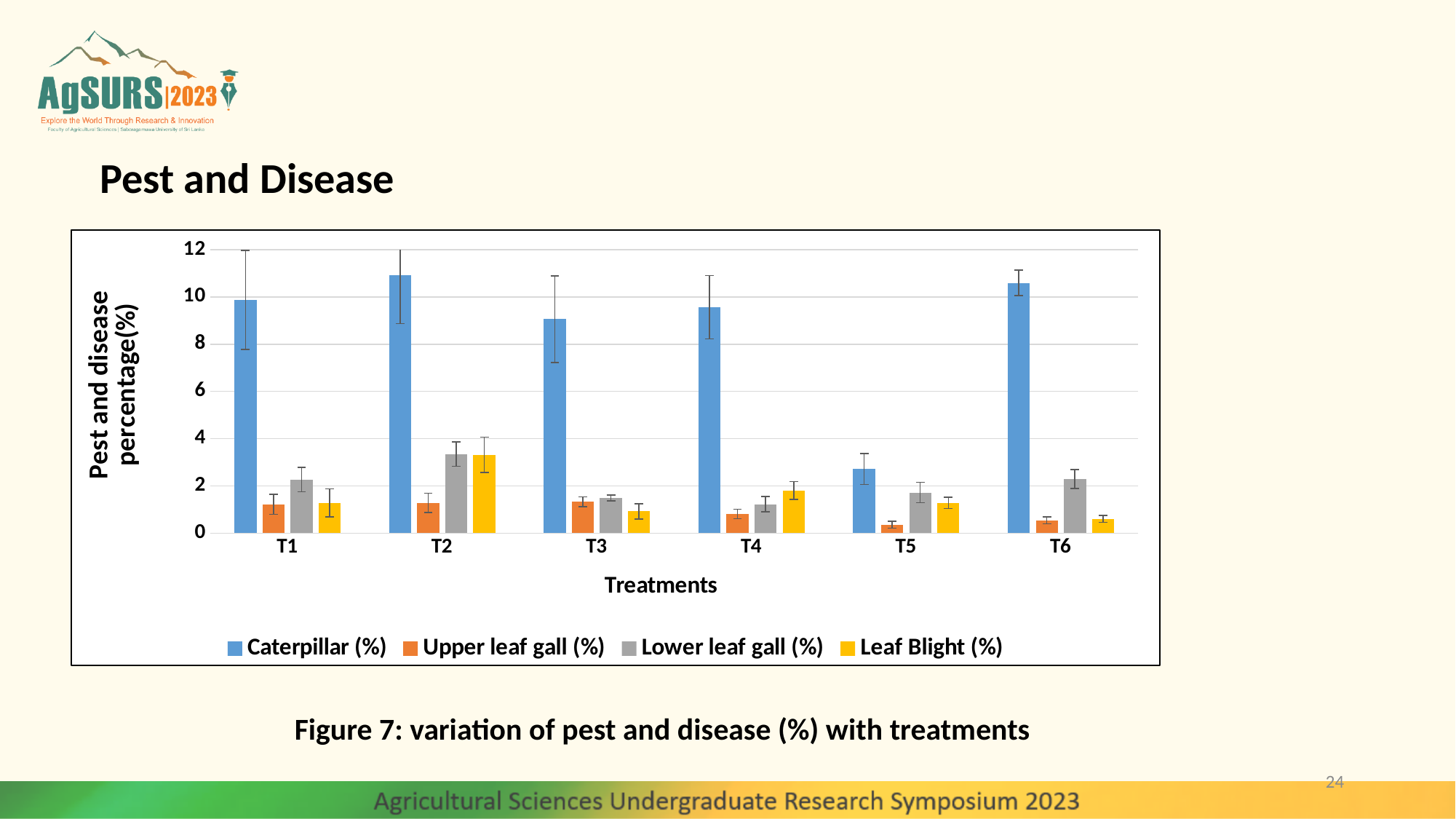
How many treatments are shown on the x axis? 6 What kind of chart is shown on the slide? bar chart Is the Caterpillar (%) value for T5 greater or less than 4? less Is the Leaf Blight (%) value for T2 greater or less than 2? greater Which treatment has the highest Leaf Blight (%) value? T2 Which is larger, the Caterpillar (%) value for T5 or for T6? T6 Is the Caterpillar (%) value for T2 greater or less than 10? greater Which treatment has the highest Lower leaf gall (%) value? T2 How many series does the legend list? 4 What is the title of the x axis? Treatments Which is larger, the Leaf Blight (%) value for T2 or for T4? T2 Which treatment has the lowest Caterpillar (%) value? T5